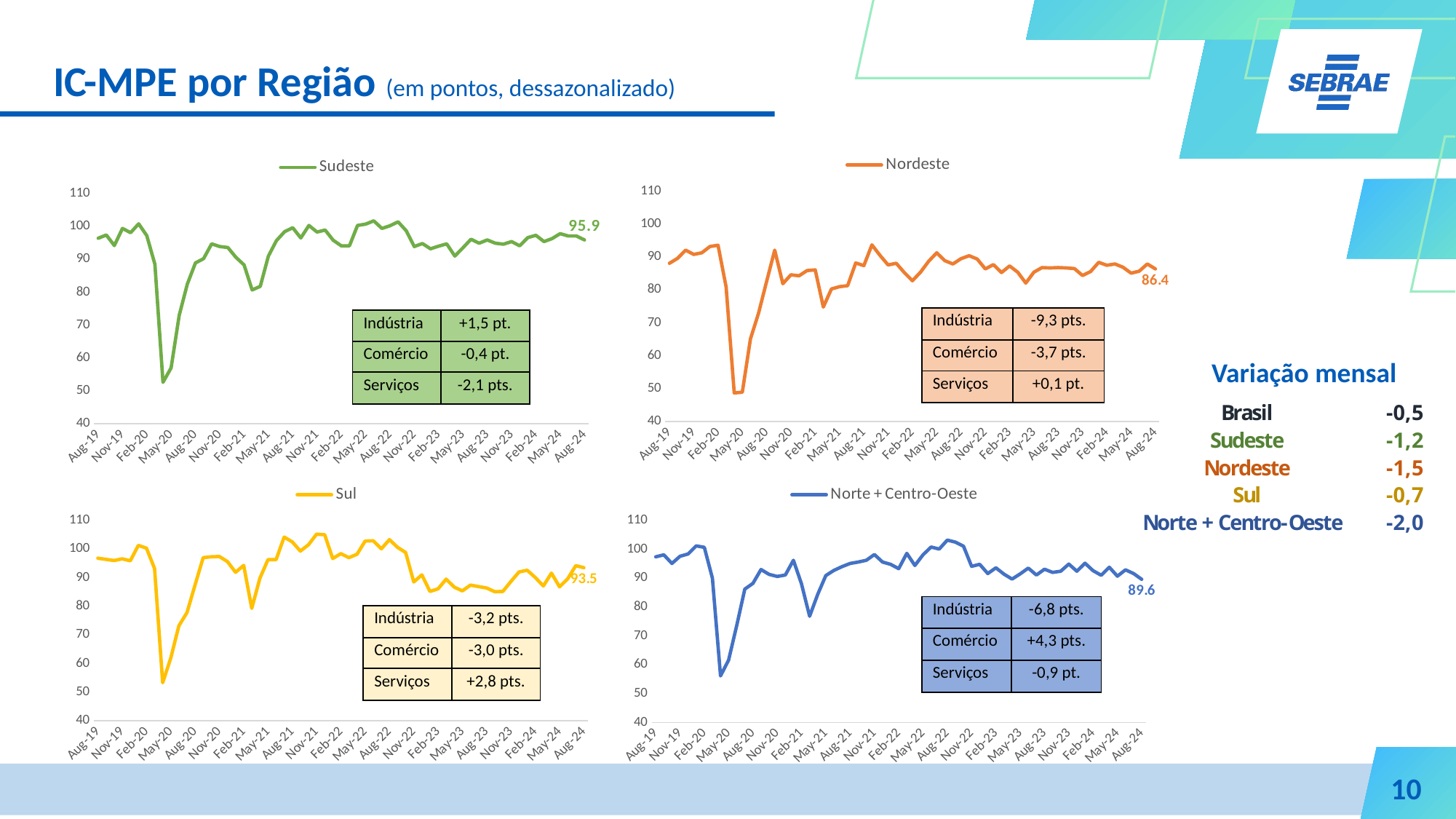
Comparing the labelled Aug-24 values across the four regional charts, which region has the lowest value? Nordeste What kind of chart is the Sudeste chart? line chart What is the difference between the labelled Aug-24 values on the Sudeste chart and the Nordeste chart? 9.5 On the Sul chart, what is the value labelled at the end of the line (Aug-24)? 93.5 How many series does the legend of the bottom-right chart list? 1 Comparing the labelled Aug-24 values across the four regional charts, which region has the highest value? Sudeste On the Nordeste chart, what is the value labelled at the end of the line (Aug-24)? 86.4 On the Norte + Centro-Oeste chart, what is the value labelled at the end of the line (Aug-24)? 89.6 On the Sudeste chart, what is the value labelled at the end of the line (Aug-24)? 95.9 On the Sudeste chart, does the line rise or fall between Feb-20 and May-20? fall On the Sudeste chart, is the lowest point of the line around May-20 greater or less than 60? less Which is larger: the labelled Aug-24 value on the Sul chart or on the Norte + Centro-Oeste chart? Sul